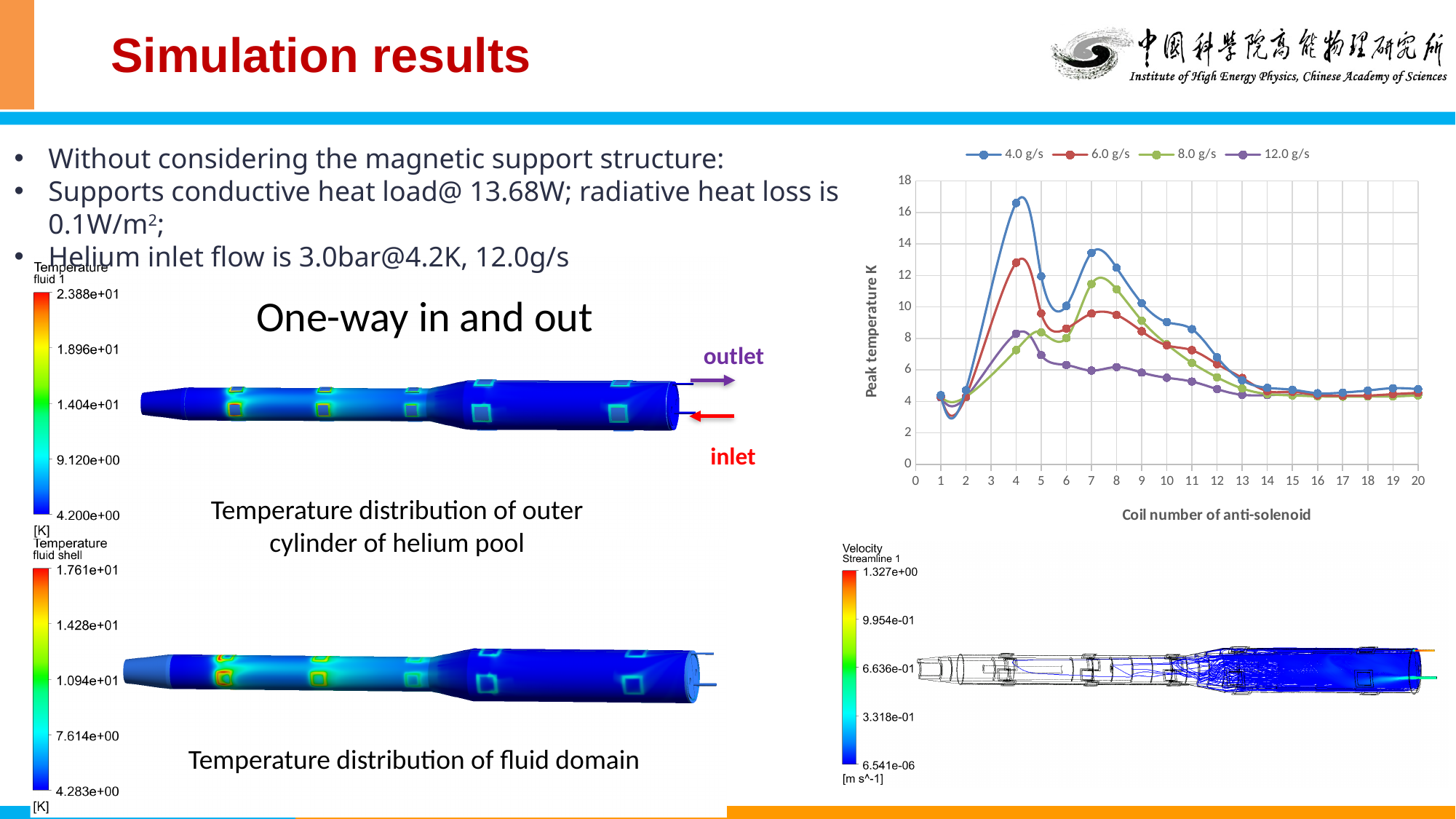
In the line chart, is the value of the 6.0 g/s series at coil number 4 greater or less than 12? greater In the line chart, at coil number 7, which series has the larger value: 4.0 g/s or 12.0 g/s? 4.0 g/s What are the legend entries of the line chart? 4.0 g/s, 6.0 g/s, 8.0 g/s, 12.0 g/s In the line chart, does the 4.0 g/s series rise or fall from coil number 4 to coil number 6? fall What is the x-axis title of the line chart? Coil number of anti-solenoid In the line chart, which series reaches the highest peak temperature? 4.0 g/s How many series does the legend of the line chart list? 4 What kind of chart is shown on the right of the slide? line chart In the line chart, is the value of the 4.0 g/s series at coil number 4 greater or less than 14? greater In the line chart, is the value of the 8.0 g/s series at coil number 7 greater or less than 10? greater In the line chart, which series has the lowest peak temperature at coil number 4? 8.0 g/s